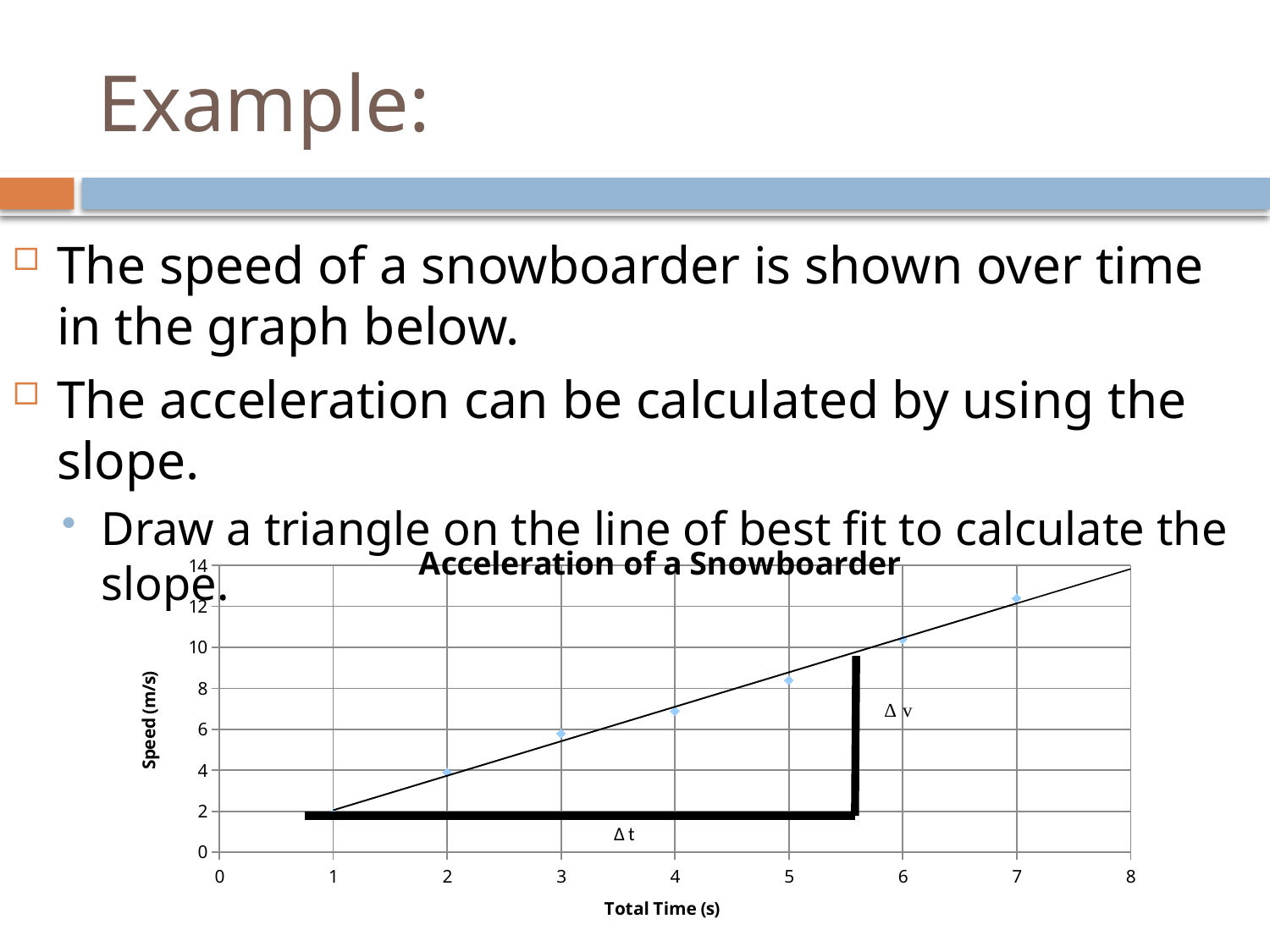
What kind of chart is shown on the slide? Scatter plot with a line of best fit What is the label on the vertical axis of the chart? Speed (m/s) How many data points are plotted on the chart? 7 Is the speed at a total time of 2 s greater or less than 6 m/s? less Is the speed at a total time of 7 s greater or less than 10 m/s? greater At which total time is the plotted speed lowest? 1 Is the speed at a total time of 4 s greater or less than 8 m/s? less At which total time is the plotted speed highest? 7 What is the title of the chart? Acceleration of a Snowboarder Does the speed rise or fall as total time increases? Rises Which is larger, the speed at a total time of 5 s or at 2 s? 5 s